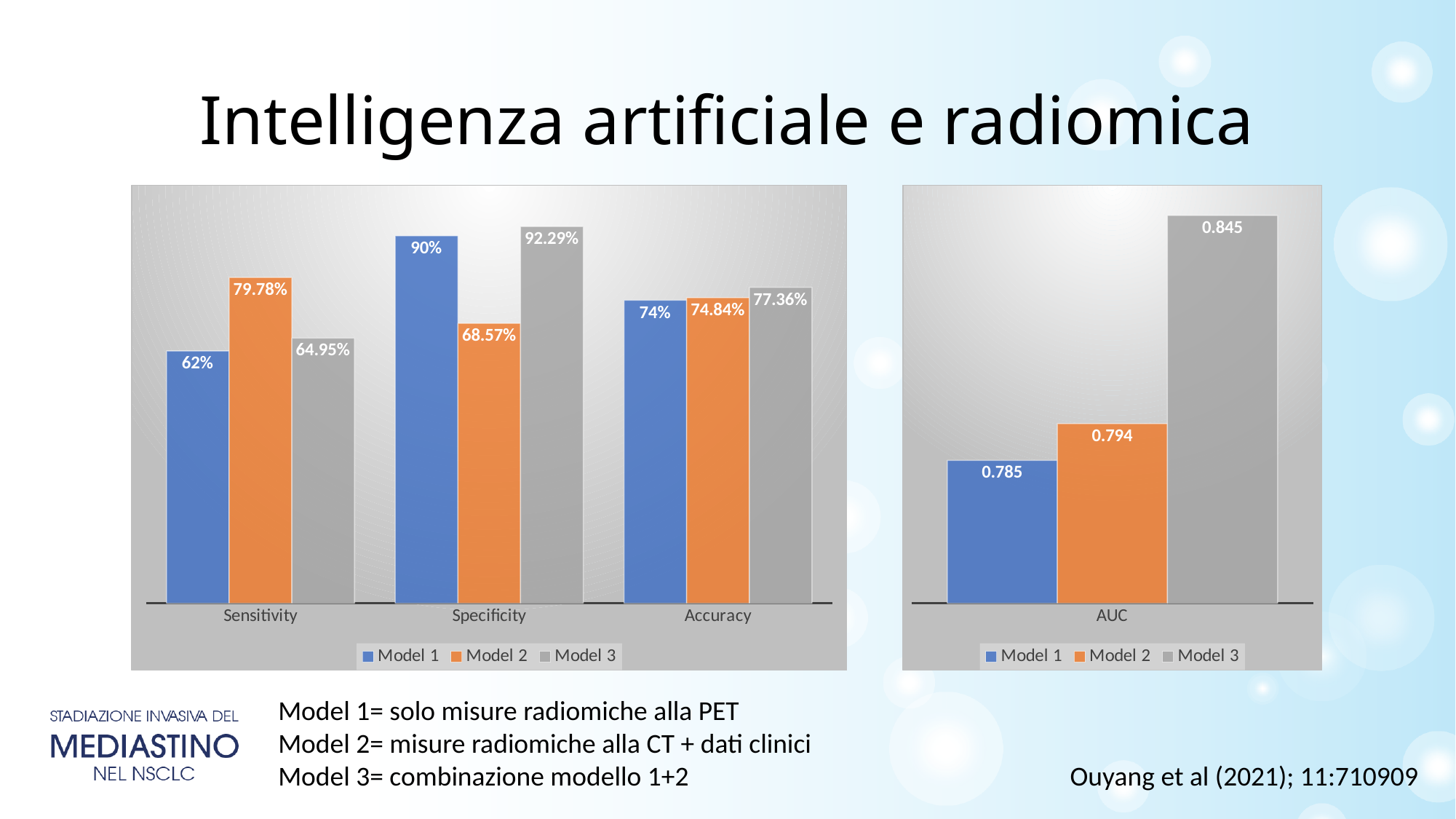
In the left chart, which model has the lowest Specificity? Model 2 In the left chart, what is the difference between the Specificity of Model 3 and Model 1? 2.29% In the right chart, what is the AUC value for Model 3? 0.845 In the right chart, what is the difference between the AUC of Model 3 and Model 2? 0.051 In the left chart, what is the Sensitivity value for Model 1? 62% In the left chart, what is the Accuracy value for Model 2? 74.84% How many categories are shown on the x axis of the left chart? 3 In the left chart, what is the Specificity value for Model 3? 92.29% In the left chart, which is larger: the Sensitivity of Model 2 or the Sensitivity of Model 3? Model 2 In the right chart, which model has the lowest AUC? Model 1 How many series does the legend of the right chart list? 3 In the left chart, which model has the highest Sensitivity? Model 2